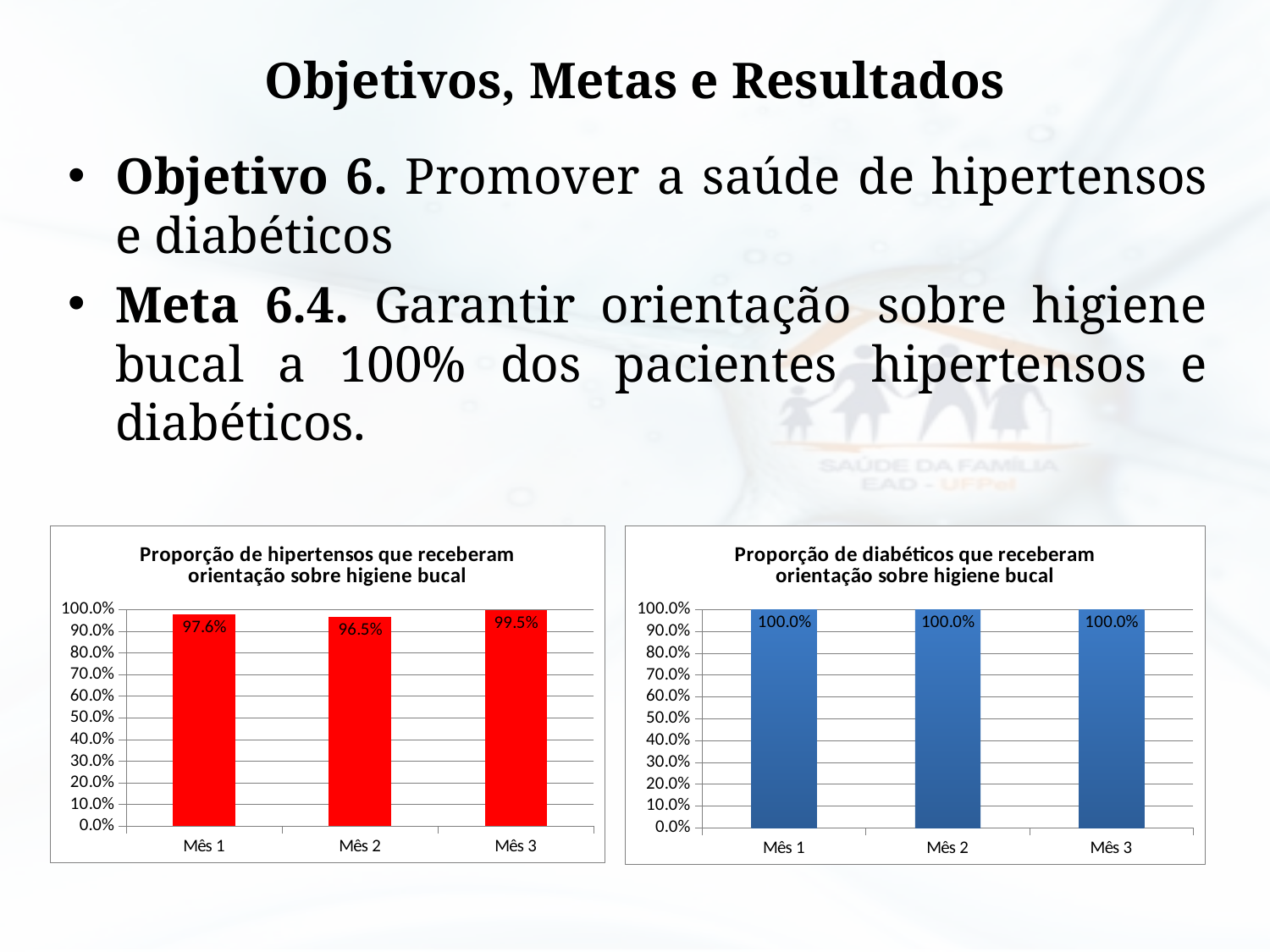
What colour are the bars in the chart 'Proporção de diabéticos que receberam orientação sobre higiene bucal'? Blue In the chart 'Proporção de diabéticos que receberam orientação sobre higiene bucal', what is the value for Mês 2? 100.0% In the chart 'Proporção de diabéticos que receberam orientação sobre higiene bucal', how many months are shown on the x axis? 3 In the chart 'Proporção de hipertensos que receberam orientação sobre higiene bucal', what is the value for Mês 3? 99.5% In the chart 'Proporção de hipertensos que receberam orientação sobre higiene bucal', what is the difference between the values for Mês 3 and Mês 2? 3.0% What kind of chart is the chart on the right of the slide? Bar chart In the chart 'Proporção de hipertensos que receberam orientação sobre higiene bucal', which month has the lowest value? Mês 2 In the chart 'Proporção de hipertensos que receberam orientação sobre higiene bucal', what is the value for Mês 1? 97.6% In the chart 'Proporção de hipertensos que receberam orientação sobre higiene bucal', is the value for Mês 2 greater or less than 90.0%? greater In the chart 'Proporção de hipertensos que receberam orientação sobre higiene bucal', which month has the highest value? Mês 3 In the chart 'Proporção de hipertensos que receberam orientação sobre higiene bucal', which is larger, the value for Mês 1 or Mês 2? Mês 1 In the chart 'Proporção de hipertensos que receberam orientação sobre higiene bucal', what is the value for Mês 2? 96.5%